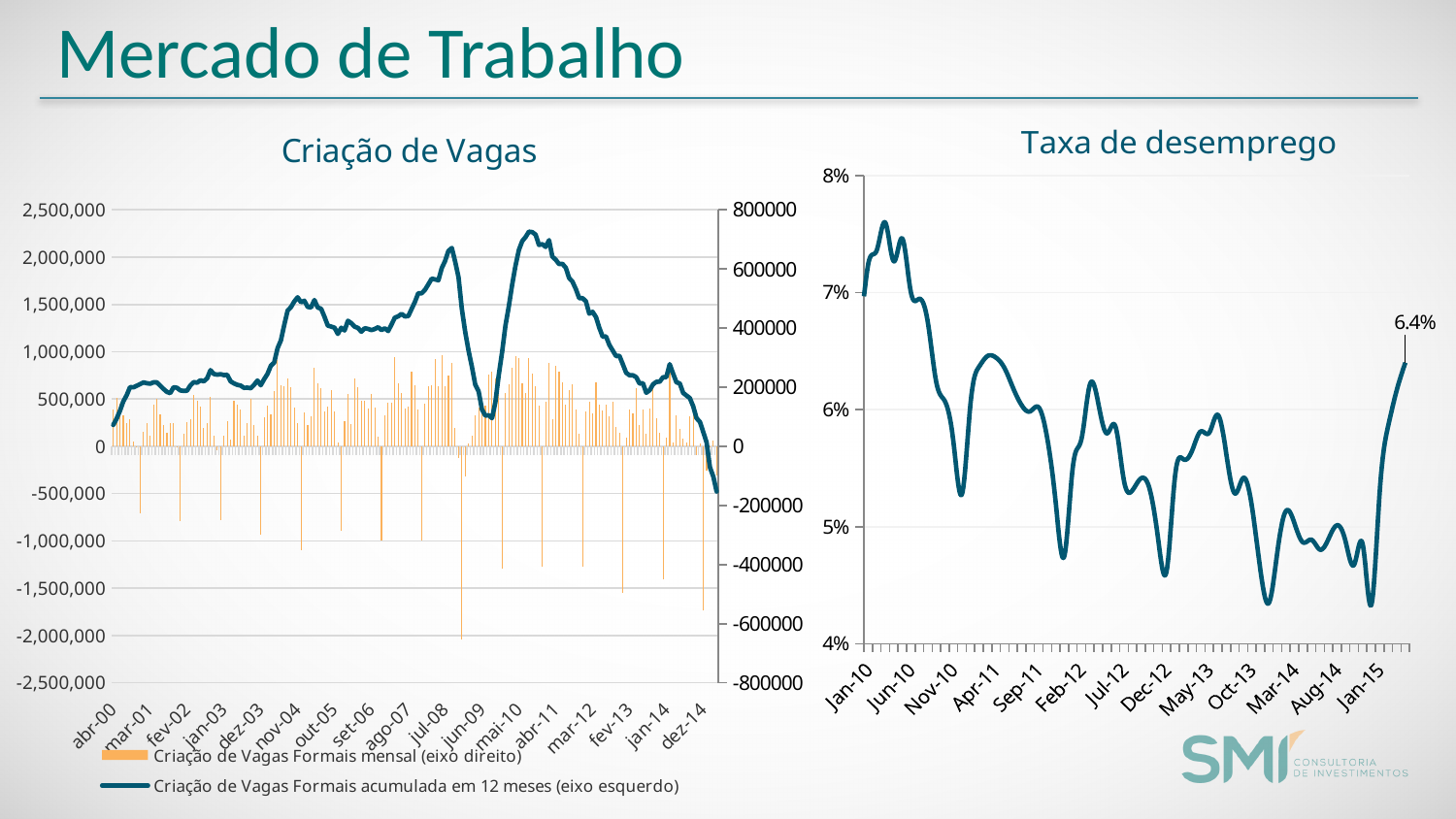
What kind of chart is the 'Taxa de desemprego' chart on the right? line chart In the 'Taxa de desemprego' chart, what is the value shown by the data label at the end of the line? 6.4% In the 'Criação de Vagas' chart, is the 12-month accumulated line at jul-08 greater or less than 1,500,000? greater In the 'Criação de Vagas' chart, which axis does the legend say the monthly bar series ('Criação de Vagas Formais mensal') uses? eixo direito How many series does the legend of the 'Criação de Vagas' chart list? 2 In the 'Taxa de desemprego' chart, is the final value (6.4%) higher or lower than the value at Jan-10? lower What is the title of the chart on the right of the slide? Taxa de desemprego What kind of chart is the 'Criação de Vagas' chart on the left? combined bar and line chart In the 'Taxa de desemprego' chart, does the unemployment rate rise or fall between Jan-10 and Nov-10? fall In the 'Taxa de desemprego' chart, is the value at Dec-12 greater or less than 5%? less